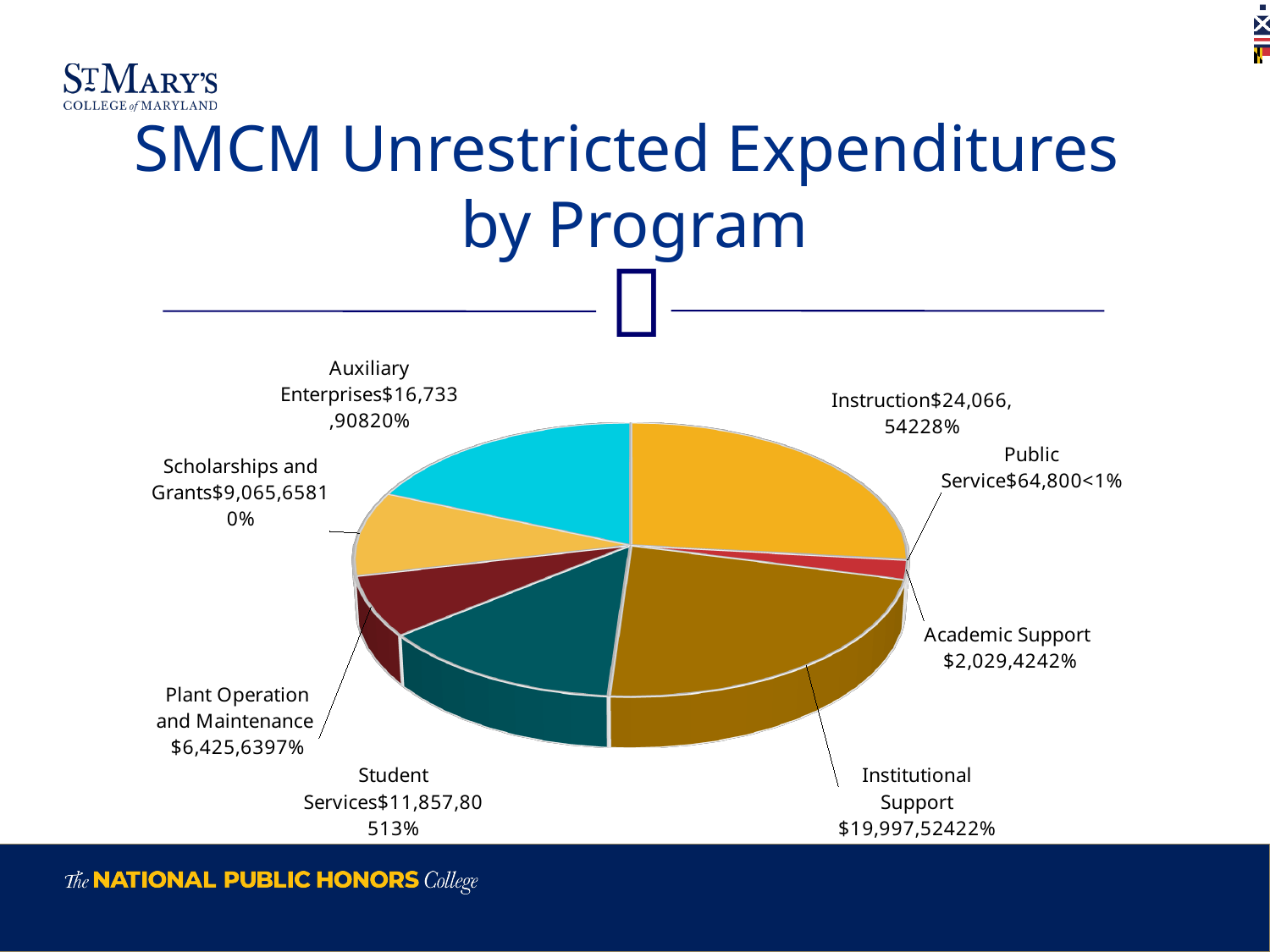
Which program has the largest slice of the pie? Instruction What is the dollar value shown for Instruction? $24,066,542 Which is larger, the slice for Auxiliary Enterprises or the slice for Plant Operation and Maintenance? Auxiliary Enterprises What is the title of the chart? SMCM Unrestricted Expenditures by Program What share of the pie does Instruction represent? 28% What share of the pie does Institutional Support represent? 22% What is the dollar value shown for Public Service? $64,800 What share of the pie does Public Service represent? <1% Which program has the smallest slice of the pie? Public Service What kind of chart is shown on the slide? pie chart Which is larger, the slice for Instruction or the slice for Academic Support? Instruction How many program categories are shown in the pie chart? 8